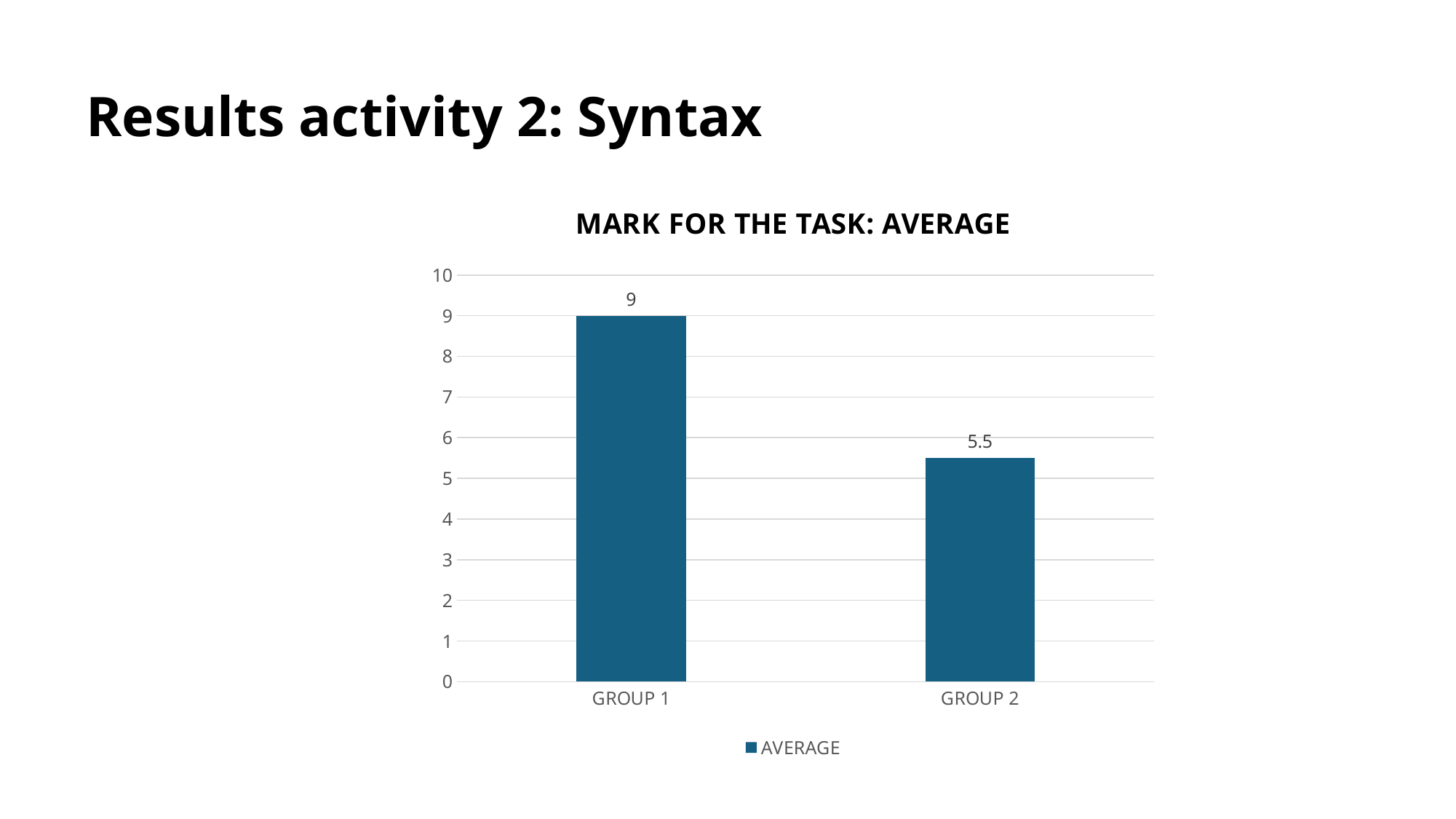
What is the average mark for GROUP 1? 9 What is the average mark for GROUP 2? 5.5 Which group has the highest average mark? GROUP 1 How many series does the legend list? 1 What kind of chart is shown on the slide? bar chart Which group has a larger average mark, GROUP 1 or GROUP 2? GROUP 1 Is the value for GROUP 2 greater or less than 6? less What is the title of the chart? MARK FOR THE TASK: AVERAGE How many groups are shown on the chart? 2 Is the value for GROUP 1 greater or less than 8? greater What is the difference between the average marks of GROUP 1 and GROUP 2? 3.5 Which group has the lowest average mark? GROUP 2